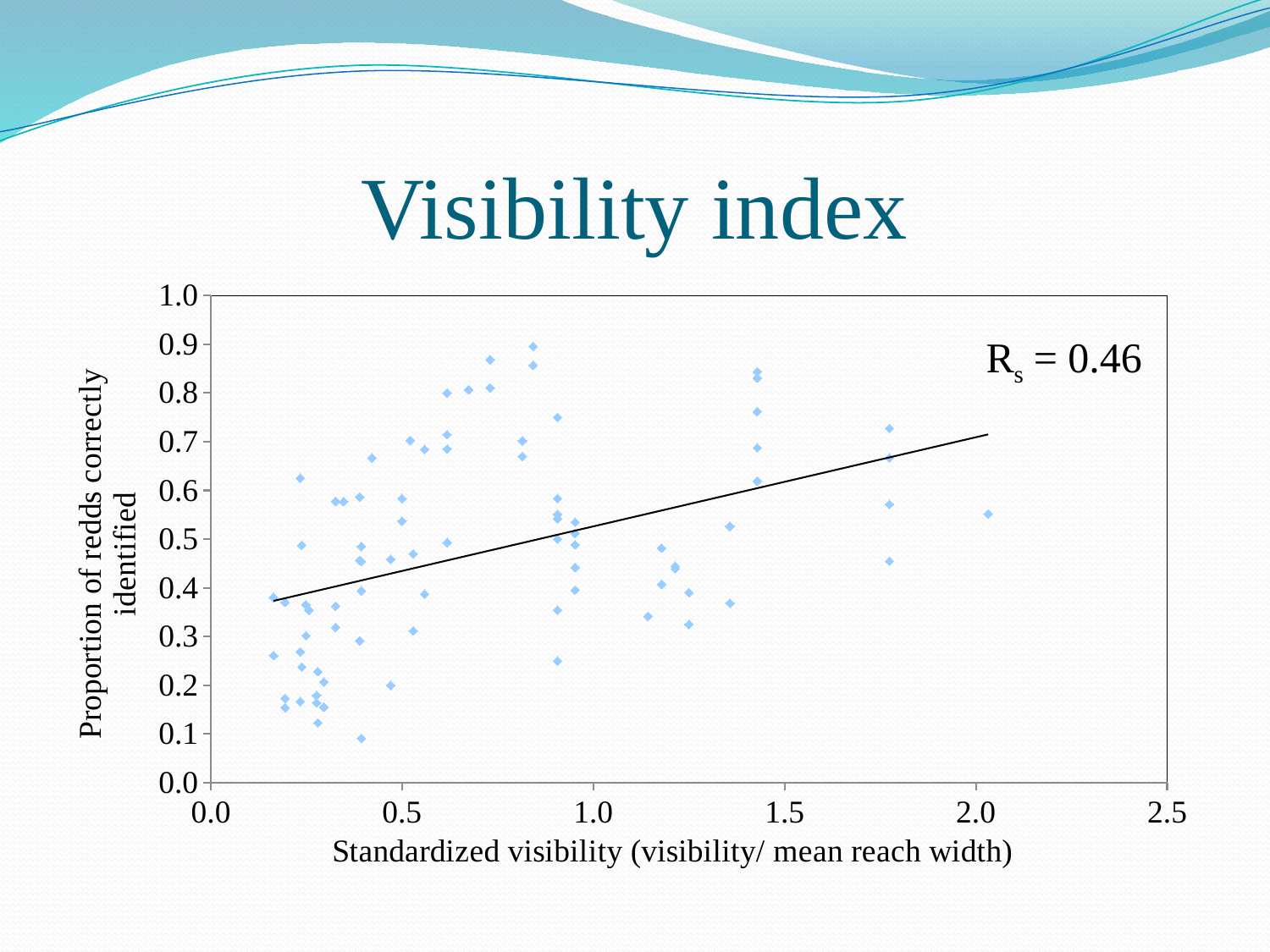
Is the y value of the lowest point on the chart greater or less than 0.2? less What value of R_s is printed on the chart? 0.46 Is the y value of the rightmost point on the chart greater or less than 0.6? less Does the fitted trend line rise or fall as standardized visibility increases along the x axis? Rises What is the title of the slide containing the chart? Visibility index Is the y value of the highest point on the chart greater or less than 0.8? greater How many data series are plotted on the chart? 1 What kind of chart is shown on the slide? Scatter plot